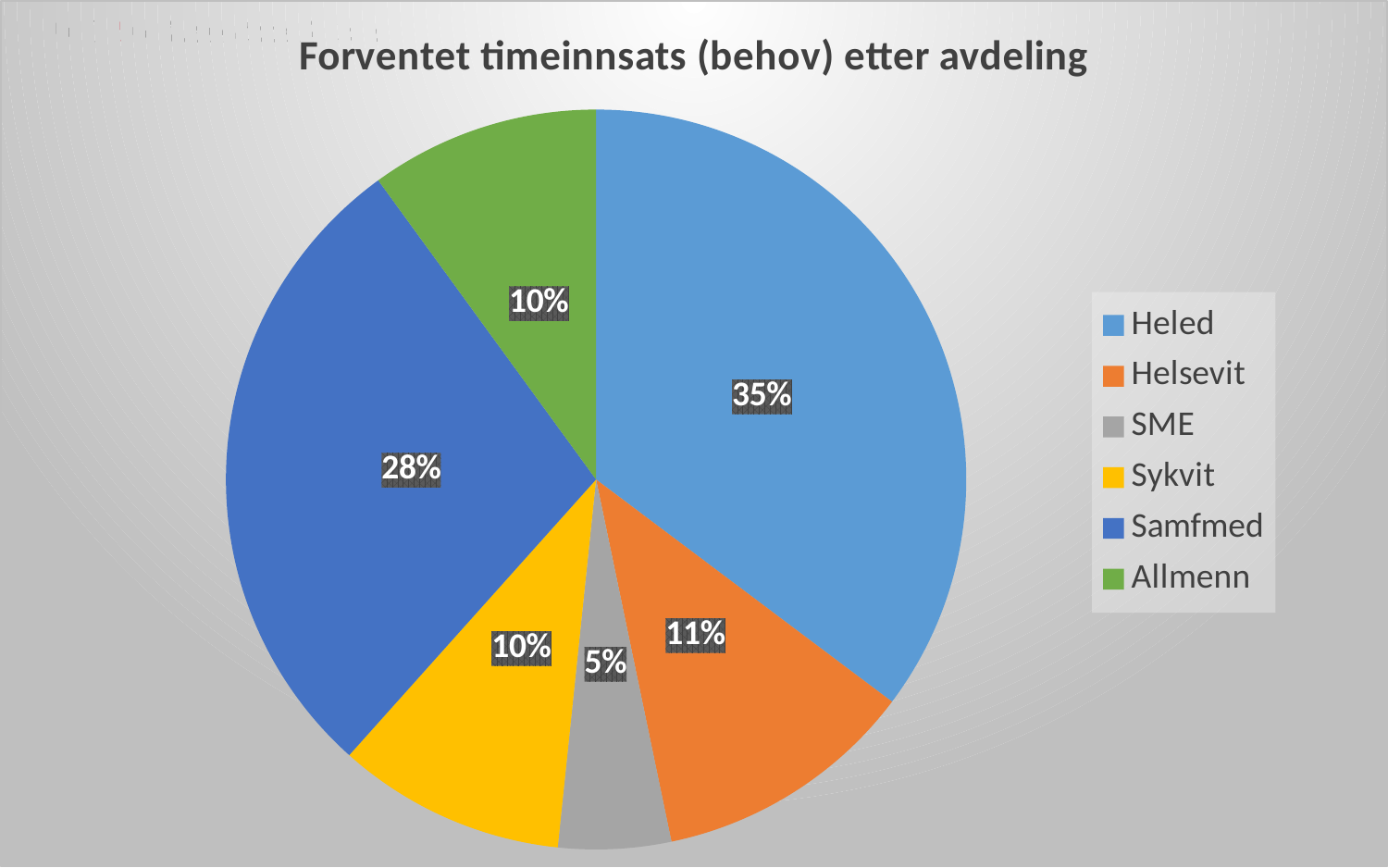
Which colour represents Allmenn in the legend? green What is the title of the chart? Forventet timeinnsats (behov) etter avdeling Which is larger, the share for Helsevit or the share for Sykvit? Helsevit What share of the pie does Samfmed have? 28% What is the difference in percentage points between Heled and Samfmed? 7 What share of the pie does Helsevit have? 11% What share of the pie does Heled have? 35% Which department has the smallest slice of the pie? SME How many slices does the pie chart have? 6 What kind of chart is shown on the slide? pie chart Which department has the largest slice of the pie? Heled